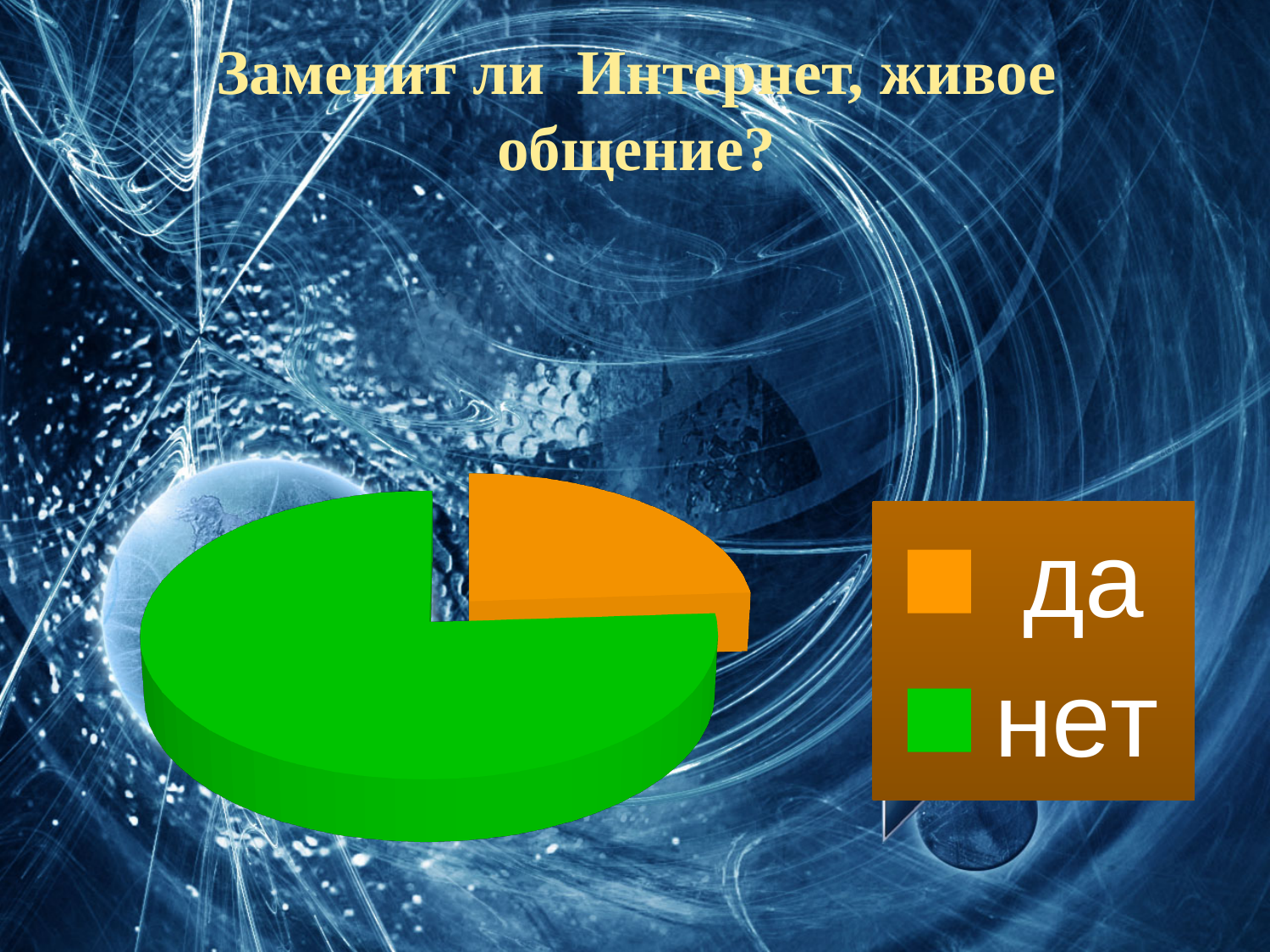
Which slice is larger in the pie chart, "да" or "нет"? нет How many slices does the pie chart have? 2 Which category has the smallest slice in the pie chart? да What kind of chart is shown on the slide? pie chart How many entries does the legend of the pie chart list? 2 What colour is the "да" slice in the pie chart? orange Which category has the largest slice in the pie chart? нет What is the title of the slide with the pie chart? Заменит ли Интернет, живое общение?